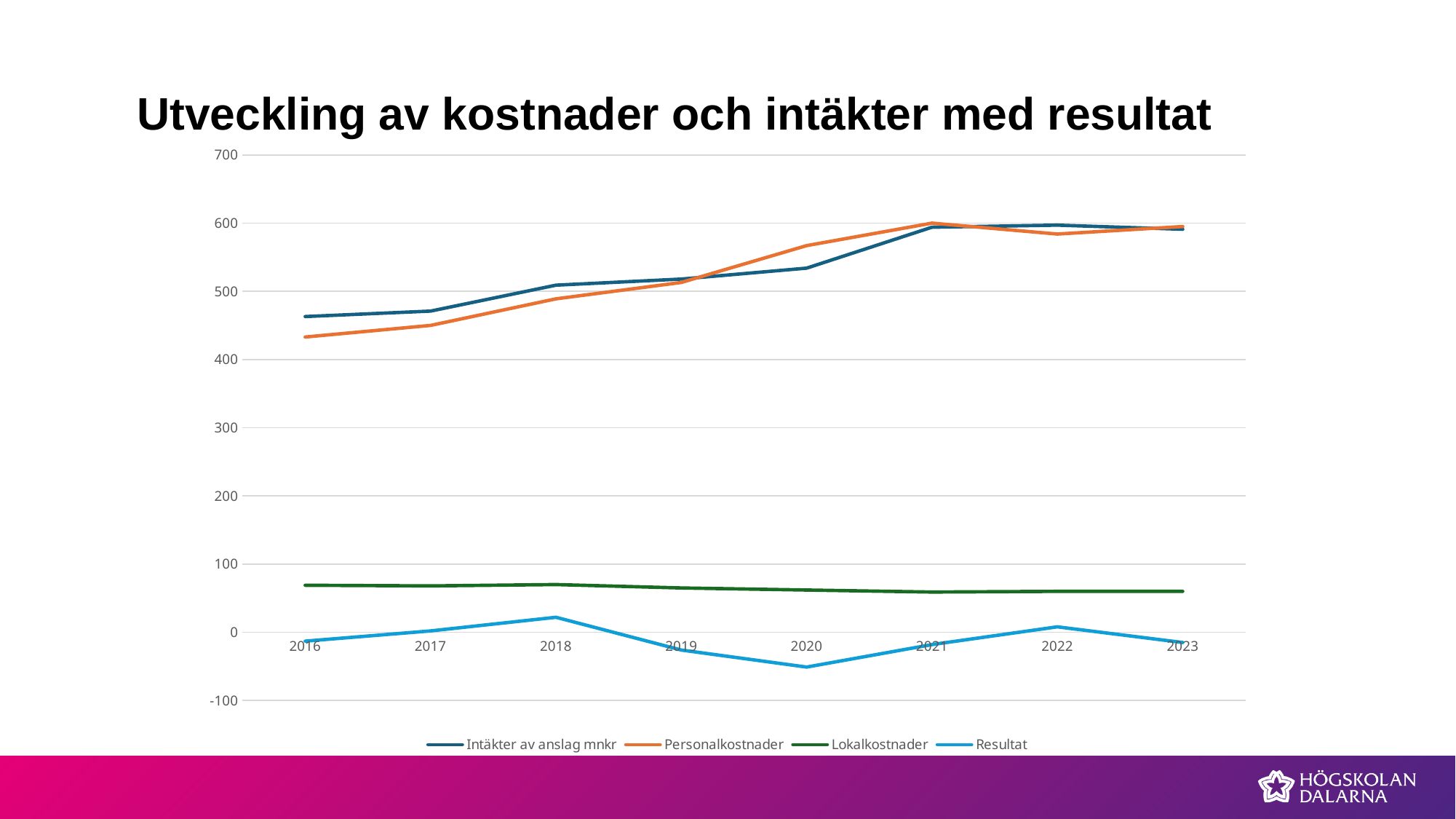
Is the value for Intäkter av anslag mnkr in 2016 greater or less than 500? less Is the value for Lokalkostnader in 2016 greater or less than 100? less What kind of chart is shown on the slide? line chart How many series does the legend list? 4 In which year is Resultat at its lowest? 2020 In 2016, which is larger: Intäkter av anslag mnkr or Personalkostnader? Intäkter av anslag mnkr Does Intäkter av anslag mnkr rise or fall from 2016 to 2021? rise In which year is Resultat at its highest? 2018 How many years are plotted along the x axis? 8 Is the value for Resultat in 2020 greater or less than 0? less In 2020, which is larger: Personalkostnader or Intäkter av anslag mnkr? Personalkostnader